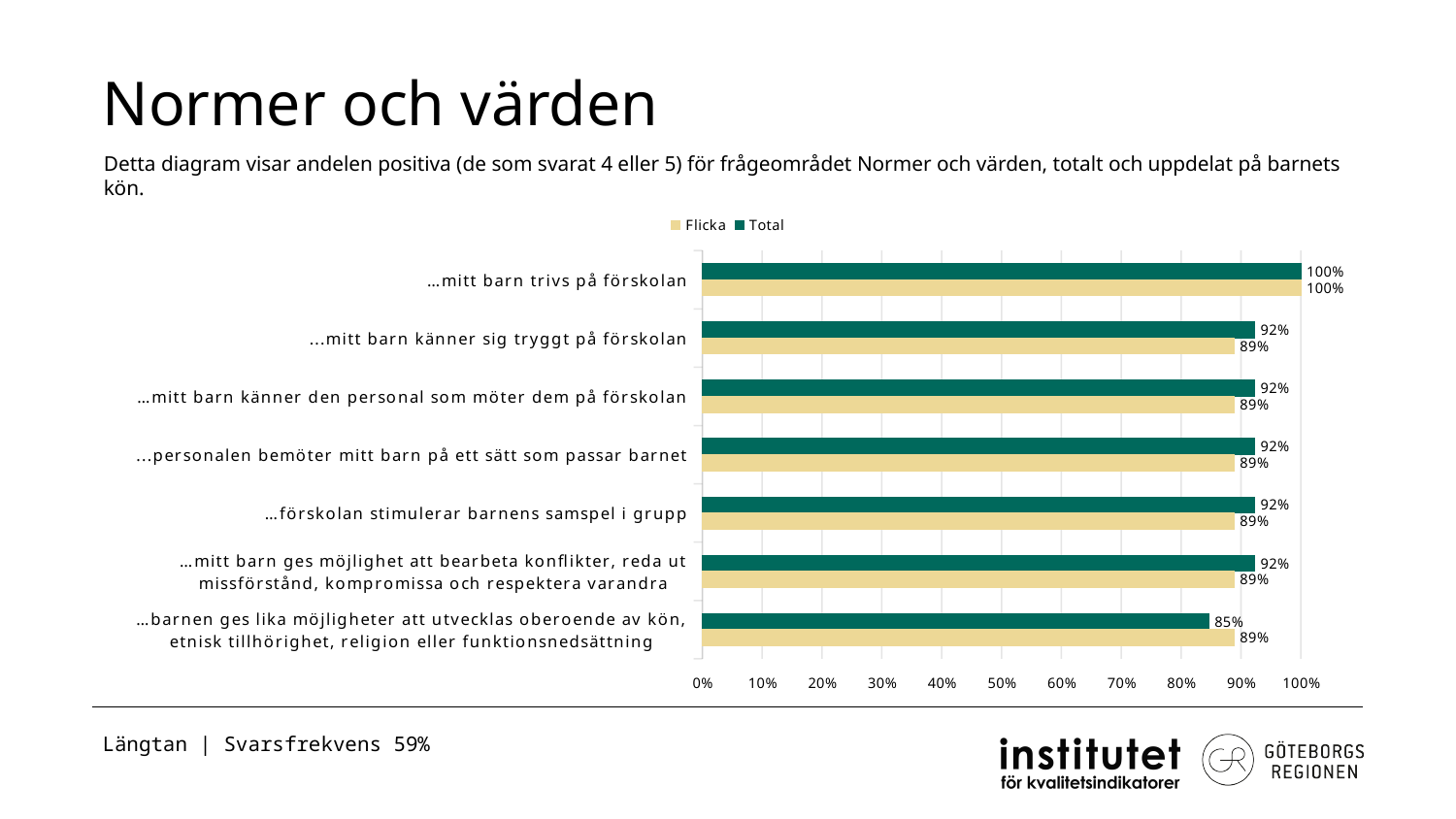
What is the difference between the Total values for "…mitt barn trivs på förskolan" and "…personalen bemöter mitt barn på ett sätt som passar barnet"? 8% How many series does the legend list? 2 What is the difference between the Total and Flicka values for "…förskolan stimulerar barnens samspel i grupp"? 3% Which category has the highest Flicka value? …mitt barn trivs på förskolan Which category has the lowest Total value? …barnen ges lika möjligheter att utvecklas oberoende av kön, etnisk tillhörighet, religion eller funktionsnedsättning For "…barnen ges lika möjligheter att utvecklas oberoende av kön, etnisk tillhörighet, religion eller funktionsnedsättning", which is larger, the Flicka value or the Total value? Flicka What is the Total value for "…mitt barn trivs på förskolan"? 100% What is the Flicka value for "…mitt barn känner sig tryggt på förskolan"? 89% What is the Total value for "…barnen ges lika möjligheter att utvecklas oberoende av kön, etnisk tillhörighet, religion eller funktionsnedsättning"? 85% Which colour represents the Total series in the chart? dark green What kind of chart is shown on the slide? bar chart How many categories are plotted in the chart? 7